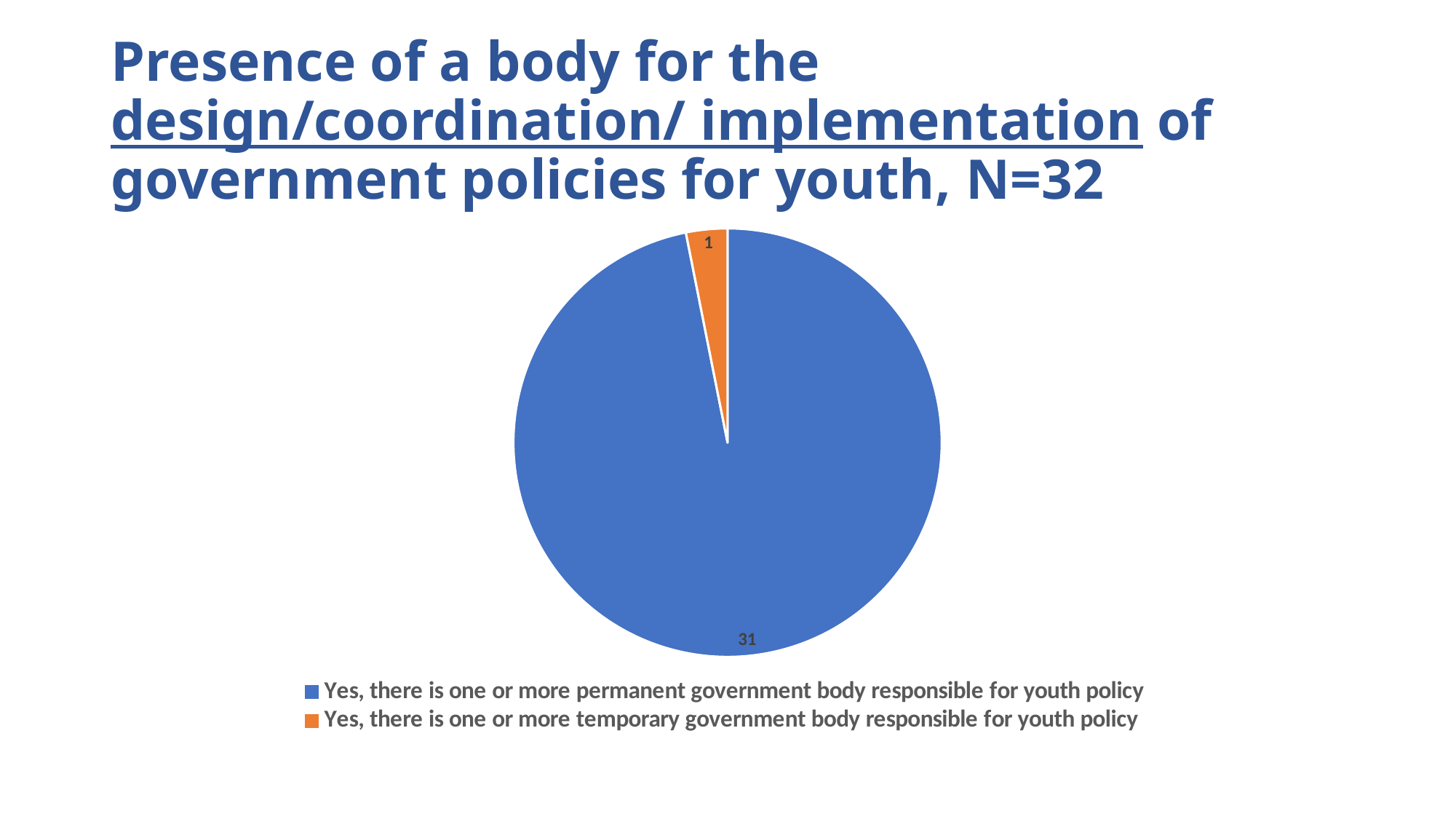
What is the difference between the permanent government body value and the temporary government body value? 30 Which is larger: the value for permanent government bodies or the value for temporary government bodies? permanent government bodies What is the value for the slice labelled 'Yes, there is one or more permanent government body responsible for youth policy'? 31 What kind of chart is shown on the slide? pie chart How many slices does the pie chart have? 2 What is the value for the slice labelled 'Yes, there is one or more temporary government body responsible for youth policy'? 1 What is the N value stated in the slide title? N=32 Which category has the largest slice of the pie? Yes, there is one or more permanent government body responsible for youth policy What is the total of the two slice values in the pie chart? 32 How many entries does the legend list? 2 Which category has the smallest slice of the pie? Yes, there is one or more temporary government body responsible for youth policy What colour is the slice for 'Yes, there is one or more temporary government body responsible for youth policy'? orange